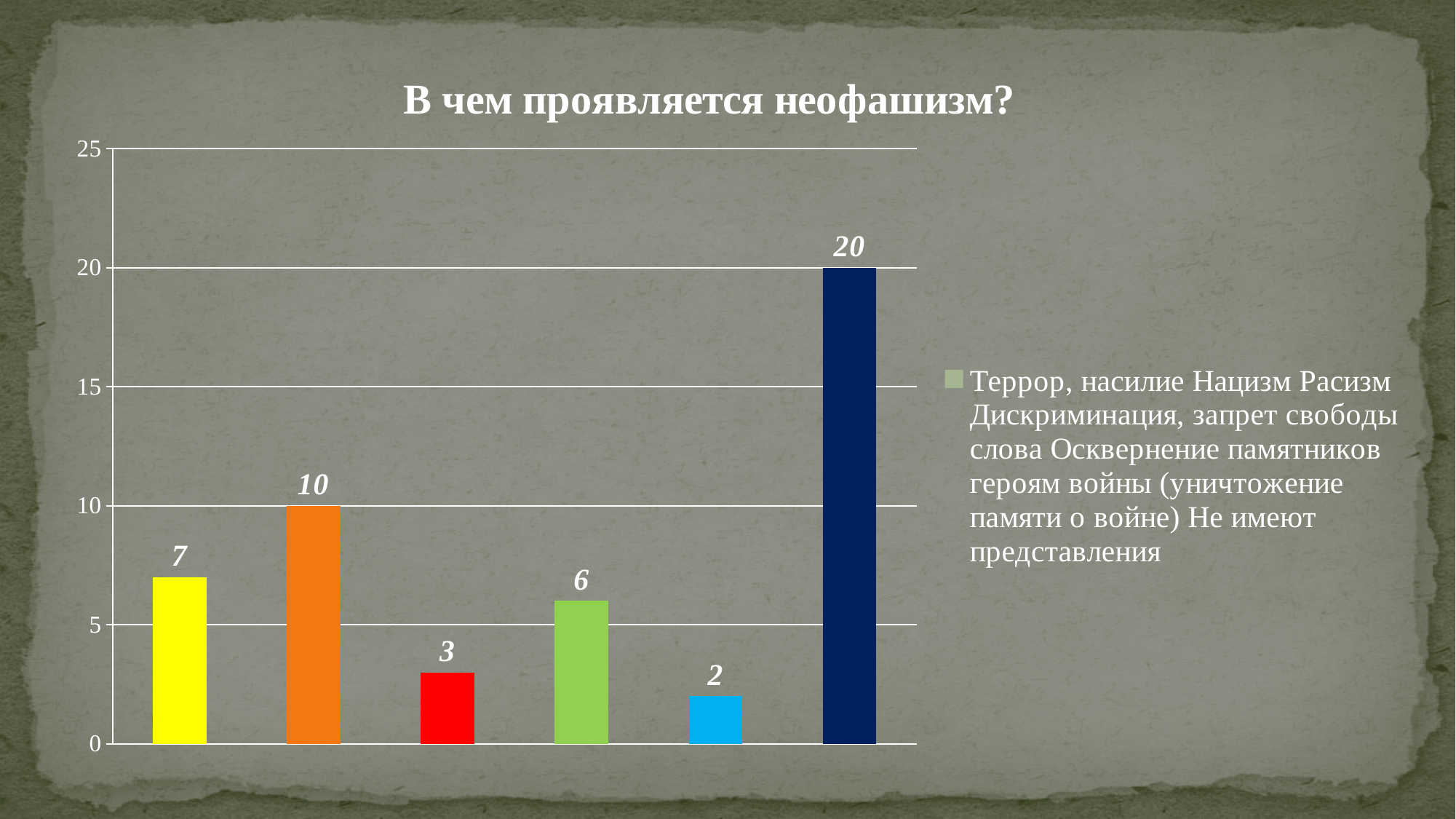
What is the value of the orange (second) bar? 10 Is the value of the dark blue (last) bar greater or less than 15? greater What is the value of the yellow (first) bar? 7 How many bars are plotted in the chart? 6 What is the value of the red (third) bar? 3 Which is larger, the green (fourth) bar or the red (third) bar? the green (fourth) bar What is the title of the chart? В чем проявляется неофашизм? What type of chart is shown on the slide? bar chart What is the difference between the dark blue bar (20) and the orange bar (10)? 10 Which bar has the lowest value? the light blue (fifth) bar, 2 Which bar has the highest value? the dark blue (last) bar, 20 What is the value of the dark blue (last) bar? 20